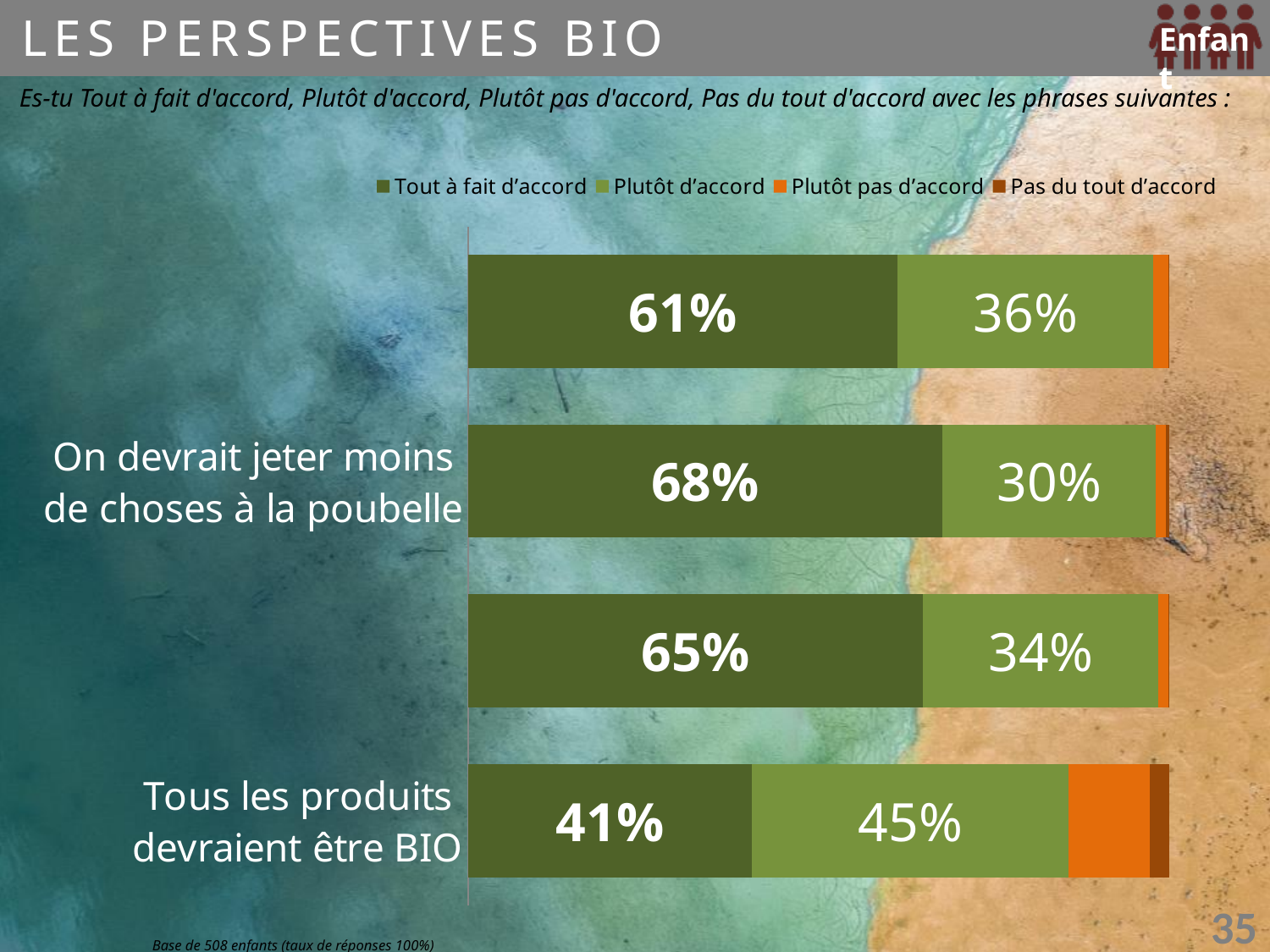
How many response categories does the legend list? 4 What percentage of children answered "Plutôt d'accord" to "Tous les produits devraient être BIO"? 45% Which statement has the lowest share of "Tout à fait d'accord" responses? Tous les produits devraient être BIO What percentage of children answered "Plutôt d'accord" to "On devrait jeter moins de choses à la poubelle"? 30% For "Tous les produits devraient être BIO", which is larger: the "Tout à fait d'accord" share or the "Plutôt d'accord" share? Plutôt d'accord What percentage of children answered "Tout à fait d'accord" to "Tous les produits devraient être BIO"? 41% What type of chart is shown on the slide? Stacked bar chart Which legend entry is shown in dark green? Tout à fait d'accord Which statement has the highest share of "Tout à fait d'accord" responses? On devrait jeter moins de choses à la poubelle How many statements (bars) are shown in the chart? 4 What percentage of children answered "Tout à fait d'accord" to "On devrait jeter moins de choses à la poubelle"? 68% What is the difference in "Tout à fait d'accord" responses between "On devrait jeter moins de choses à la poubelle" and "Tous les produits devraient être BIO"? 27 percentage points